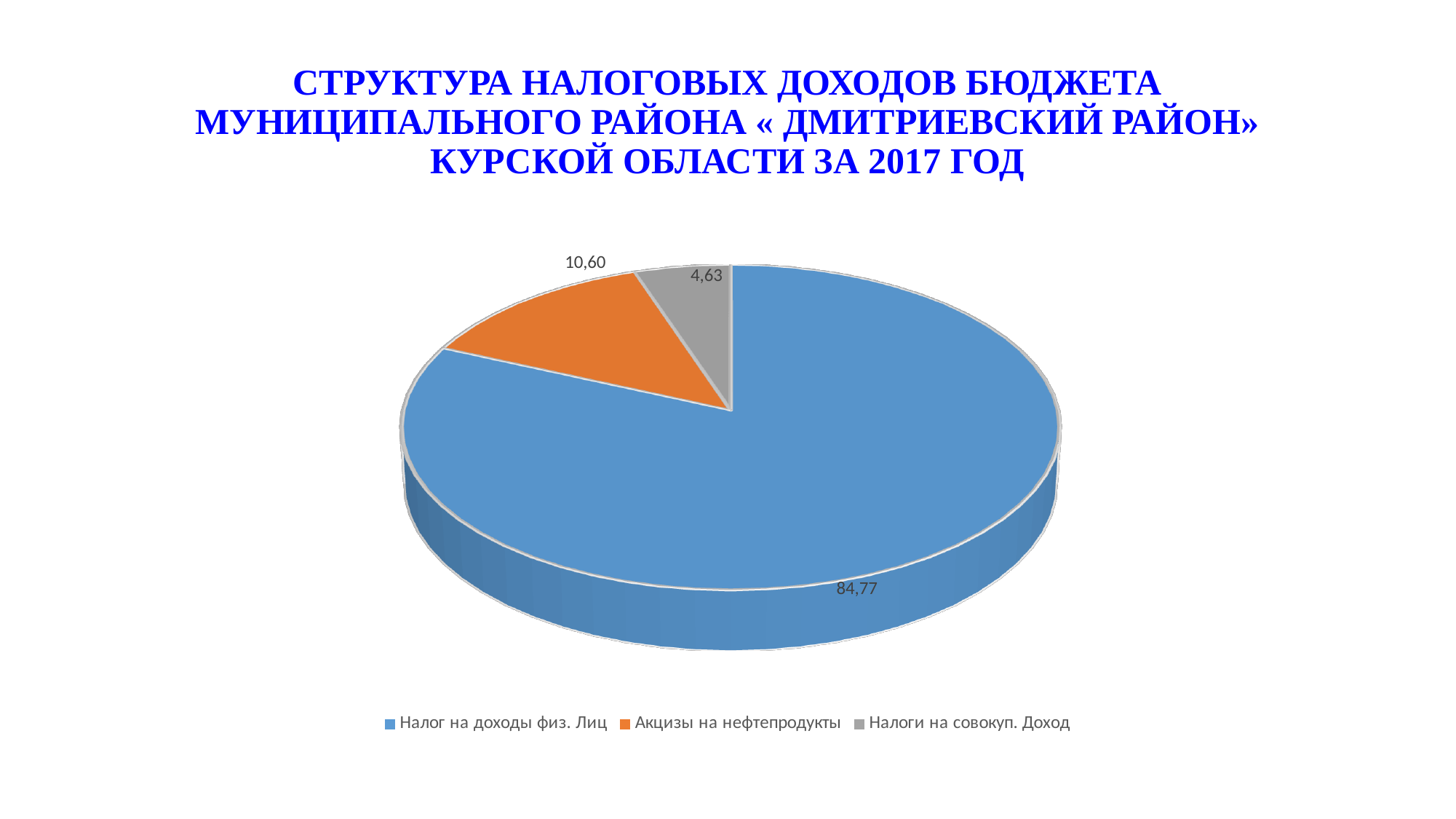
What kind of chart is shown on the slide? Pie chart What value is shown for Налоги на совокуп. Доход? 4,63 What share of the pie does Налог на доходы физ. Лиц take? 84,77 What is the difference between the values for Налог на доходы физ. Лиц and Акцизы на нефтепродукты? 74,17 What value is shown for Акцизы на нефтепродукты? 10,60 What is the difference between the values for Акцизы на нефтепродукты and Налоги на совокуп. Доход? 5,97 How many slices does the pie chart have? 3 Which category has the largest slice of the pie? Налог на доходы физ. Лиц Which category has the smallest slice of the pie? Налоги на совокуп. Доход Which is larger, the value for Акцизы на нефтепродукты or the value for Налоги на совокуп. Доход? Акцизы на нефтепродукты Which colour represents Акцизы на нефтепродукты in the legend? Orange What value is shown for Налог на доходы физ. Лиц? 84,77